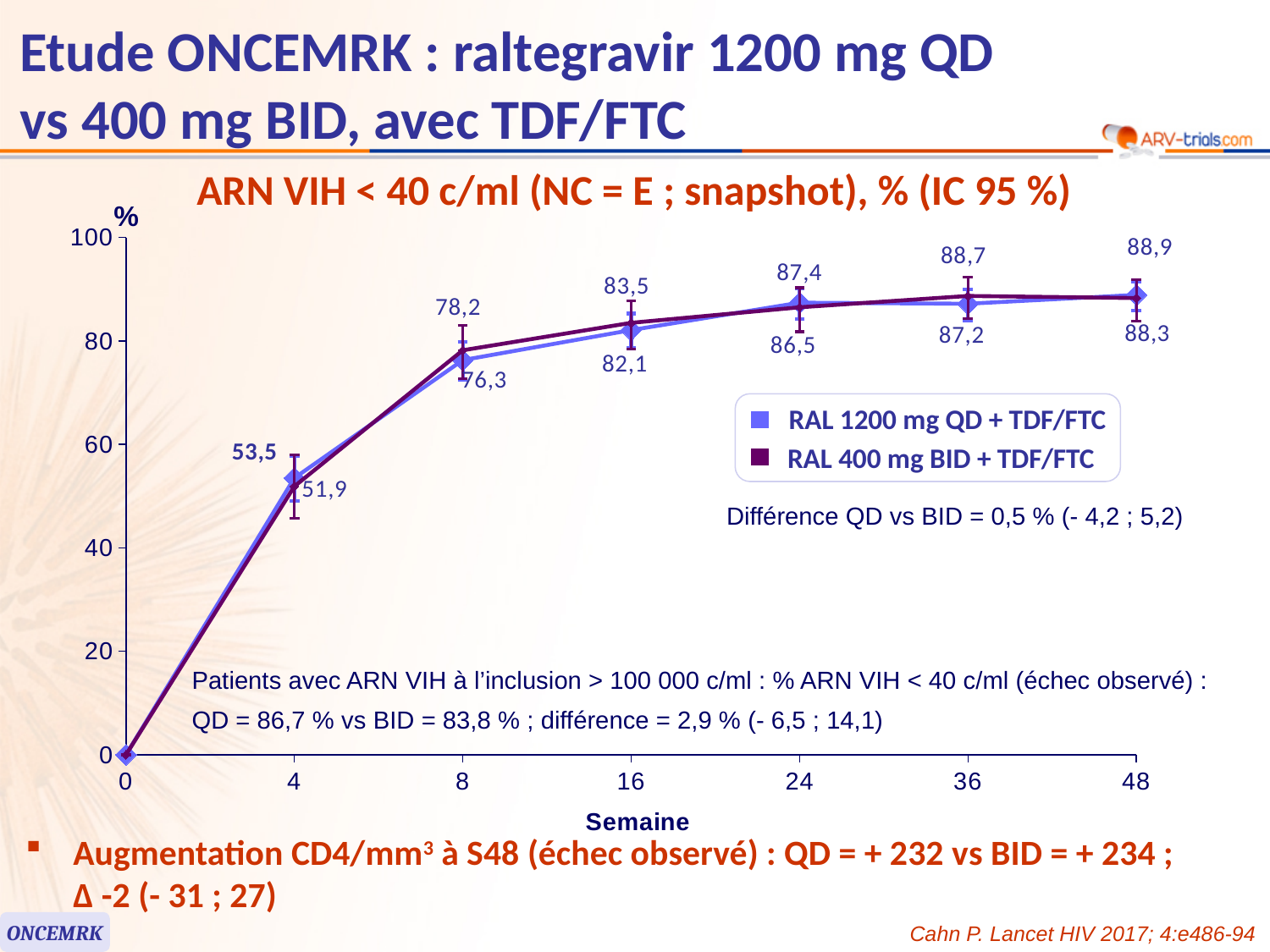
What difference QD vs BID is stated on the chart? 0,5 % (- 4,2 ; 5,2) What kind of chart is shown on the slide? line chart What is the value of both series at week 0? 0 What is the higher of the two values shown at week 48? 88,9 How many series does the legend list? 2 What is the label of the x axis? Semaine How many time points (weeks) are marked on the x axis? 7 What are the two values labelled at week 8? 78,2 and 76,3 What is the lower of the two values shown at week 48? 88,3 Do the values rise or fall from week 0 to week 48? rise What is the difference between the two values labelled at week 4 (53,5 and 51,9)? 1,6 Are the values at week 4 greater or less than 60? less